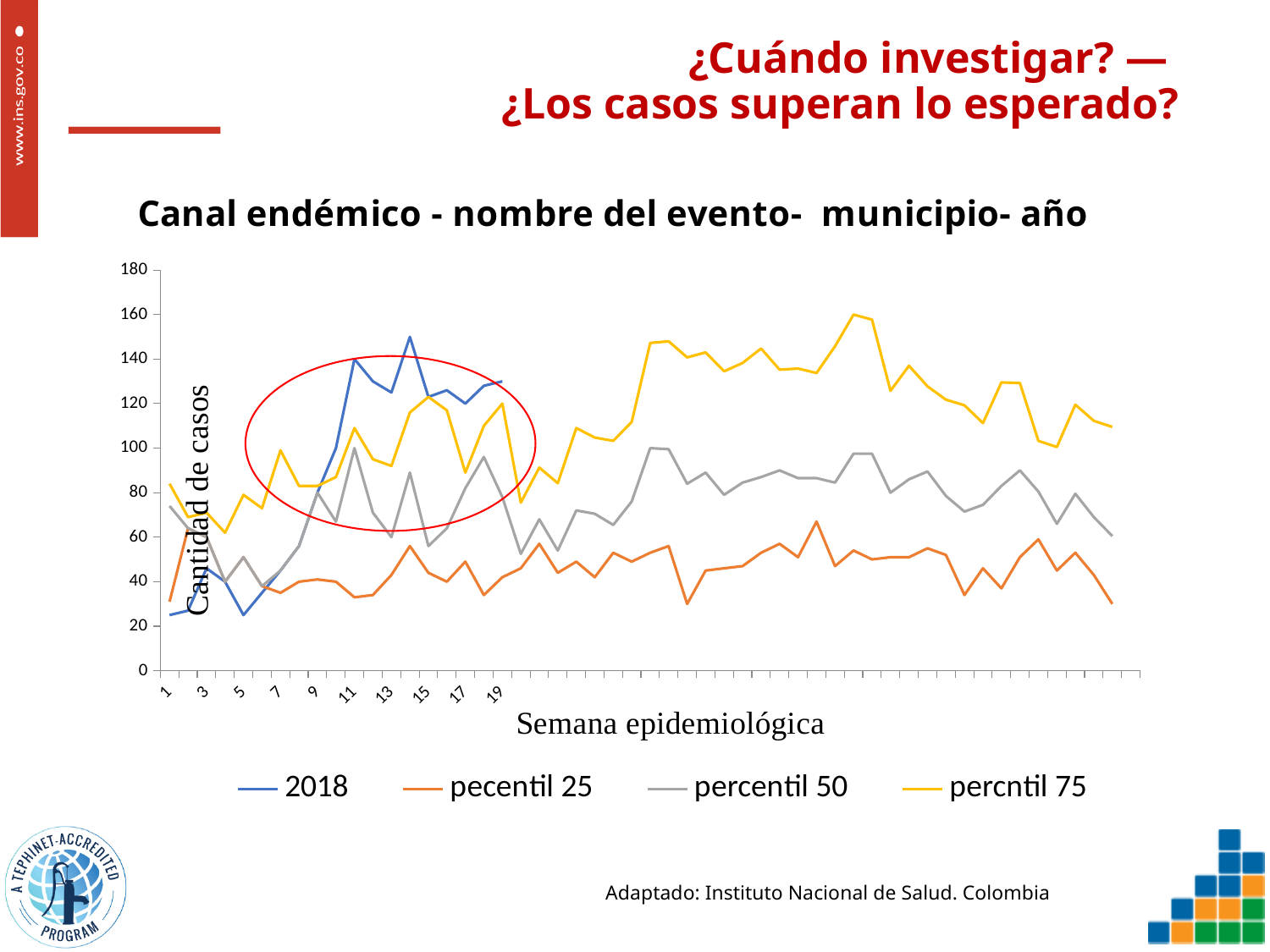
Is the peak value of the 2018 series (around week 14) greater or less than 140? greater Is the highest value of the percntil 75 series greater or less than 140? greater Is the value of the pecentil 25 series at week 1 greater or less than 40? less Which series has the highest values across most of the chart? percntil 75 Which series has the lowest values across most of the chart? pecentil 25 What is the title of the chart? Canal endémico - nombre del evento- municipio- año What is the label of the x axis? Semana epidemiológica What kind of chart is shown on the slide? line chart At week 14, which is larger: the 2018 series or the percntil 75 series? 2018 How many series does the legend list? 4